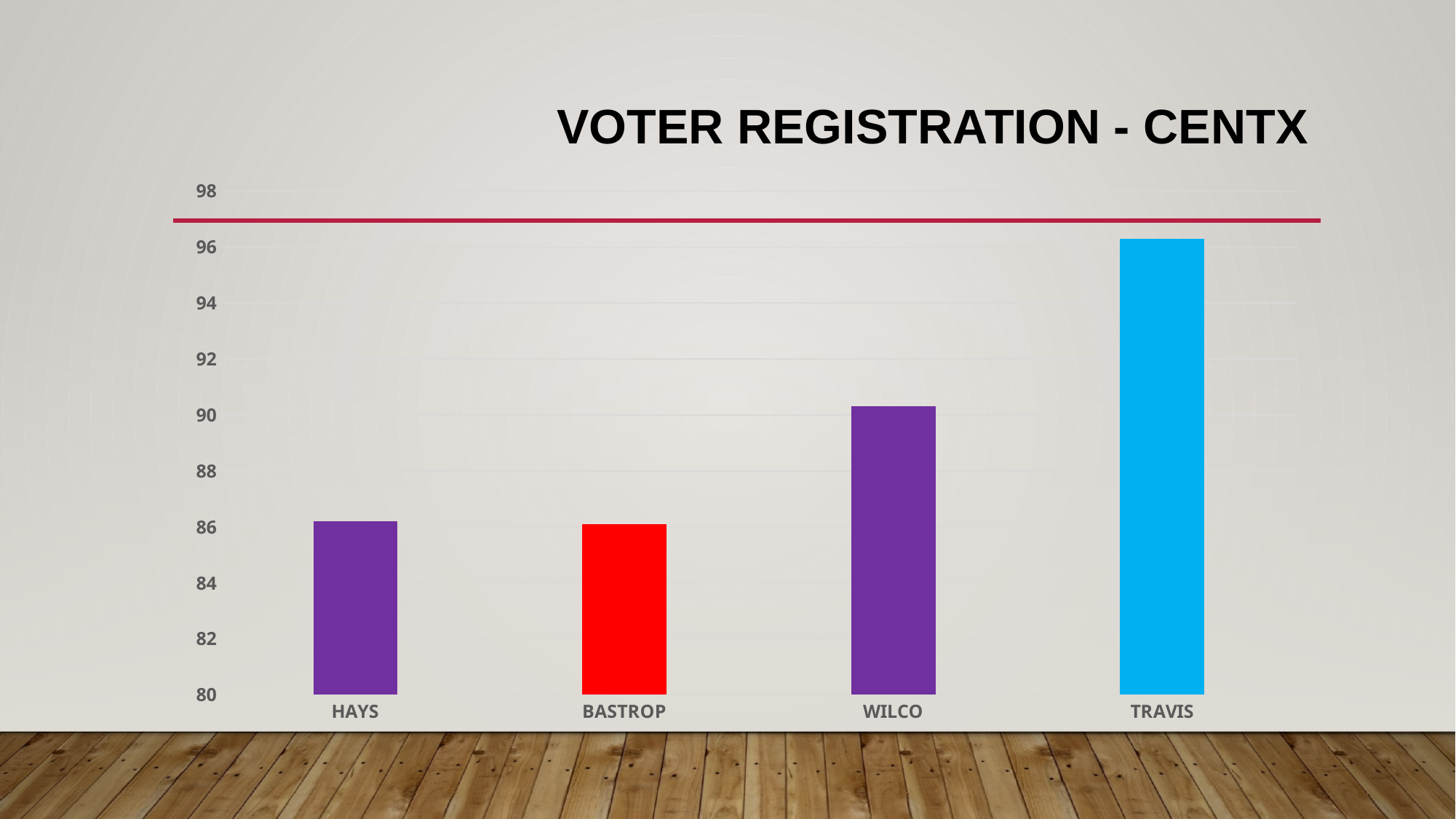
What is the title of the chart? VOTER REGISTRATION - CENTX Is the value for TRAVIS greater or less than 94? greater Which is larger, the value for TRAVIS or the value for WILCO? TRAVIS How many categories are shown on the x axis? 4 Which category has the highest value? TRAVIS Is the value for HAYS greater or less than 88? less Is the value for WILCO greater or less than 92? less What kind of chart is shown on the slide? bar chart What colour is the bar for BASTROP? red Which is larger, the value for WILCO or the value for BASTROP? WILCO